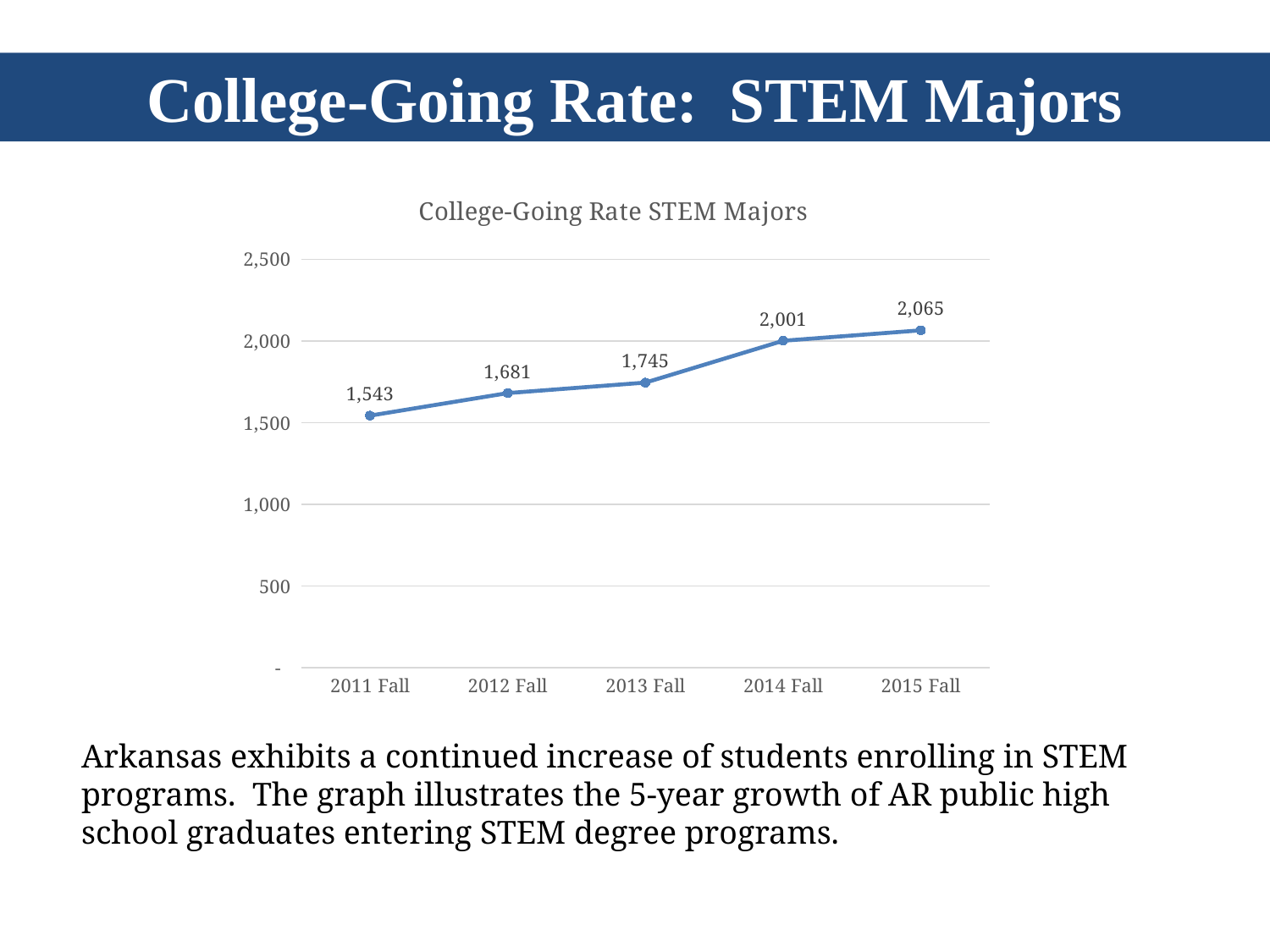
Which year has the highest value? 2015 Fall What is the difference between the values for 2014 Fall and 2013 Fall? 256 Is the value for 2014 Fall greater or less than 1,500? greater What is the value for 2011 Fall? 1,543 Do the values rise or fall from 2011 Fall to 2015 Fall? rise What is the value for 2013 Fall? 1,745 What is the value for 2015 Fall? 2,065 Which is larger, the value for 2012 Fall or the value for 2013 Fall? 2013 Fall What is the difference between the values for 2015 Fall and 2011 Fall? 522 Which year has the lowest value? 2011 Fall What kind of chart is shown on the slide? line chart How many data points are plotted on the chart? 5